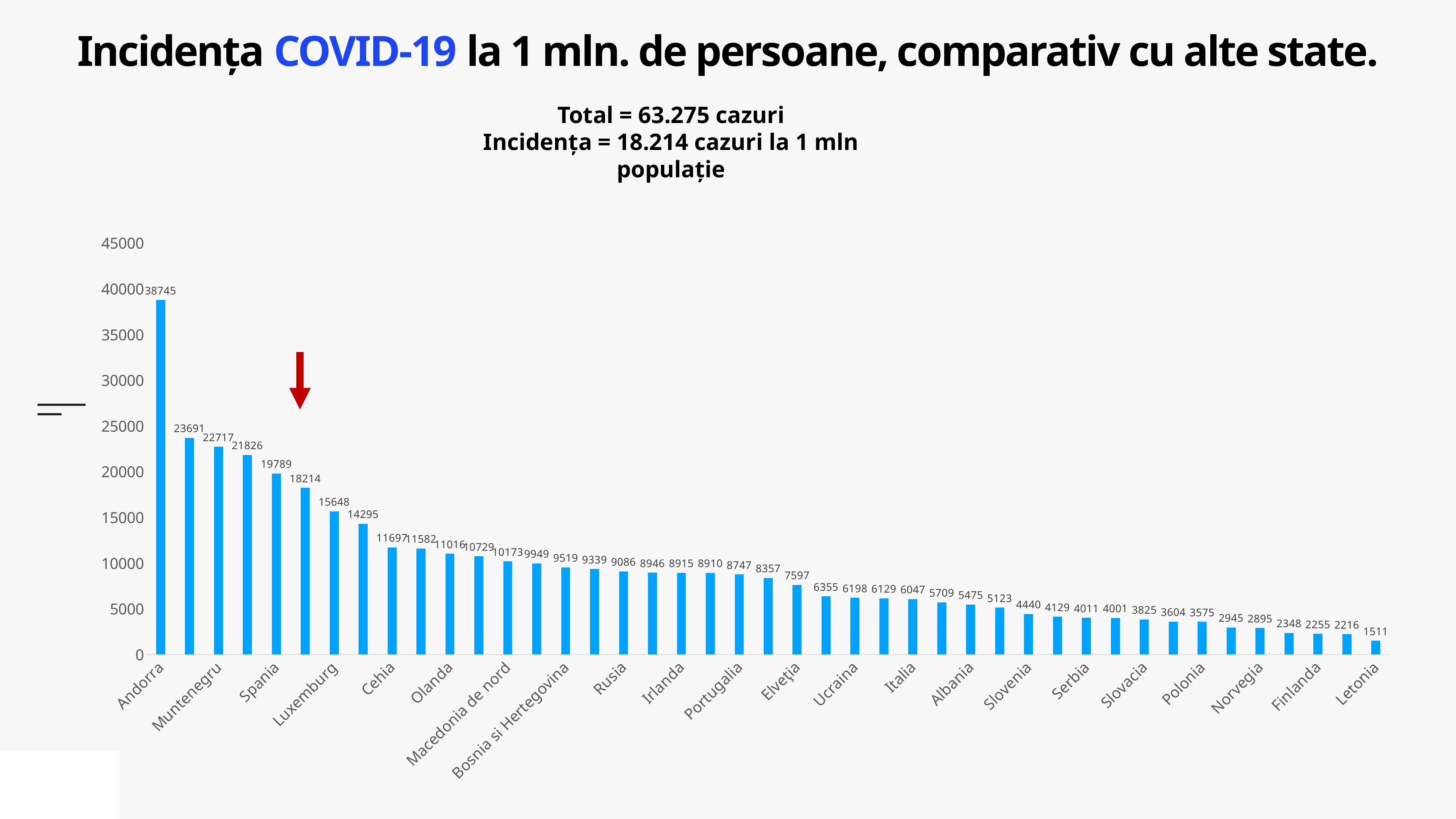
Which country has the lowest incidence? Letonia What is the value for Andorra? 38745 Which is larger, the value for Spania or the value for Cehia? Spania What is the value for Luxemburg? 15648 What is the value for Spania? 19789 What is the value for Letonia? 1511 What value is printed on the bar that the red arrow points to? 18214 Is the value for Italia greater or less than 10000? less Do the values rise or fall from left to right along the x axis? fall Which country has the highest incidence? Andorra What kind of chart is shown on the slide? bar chart What is the difference between the values for Andorra and Letonia? 37234